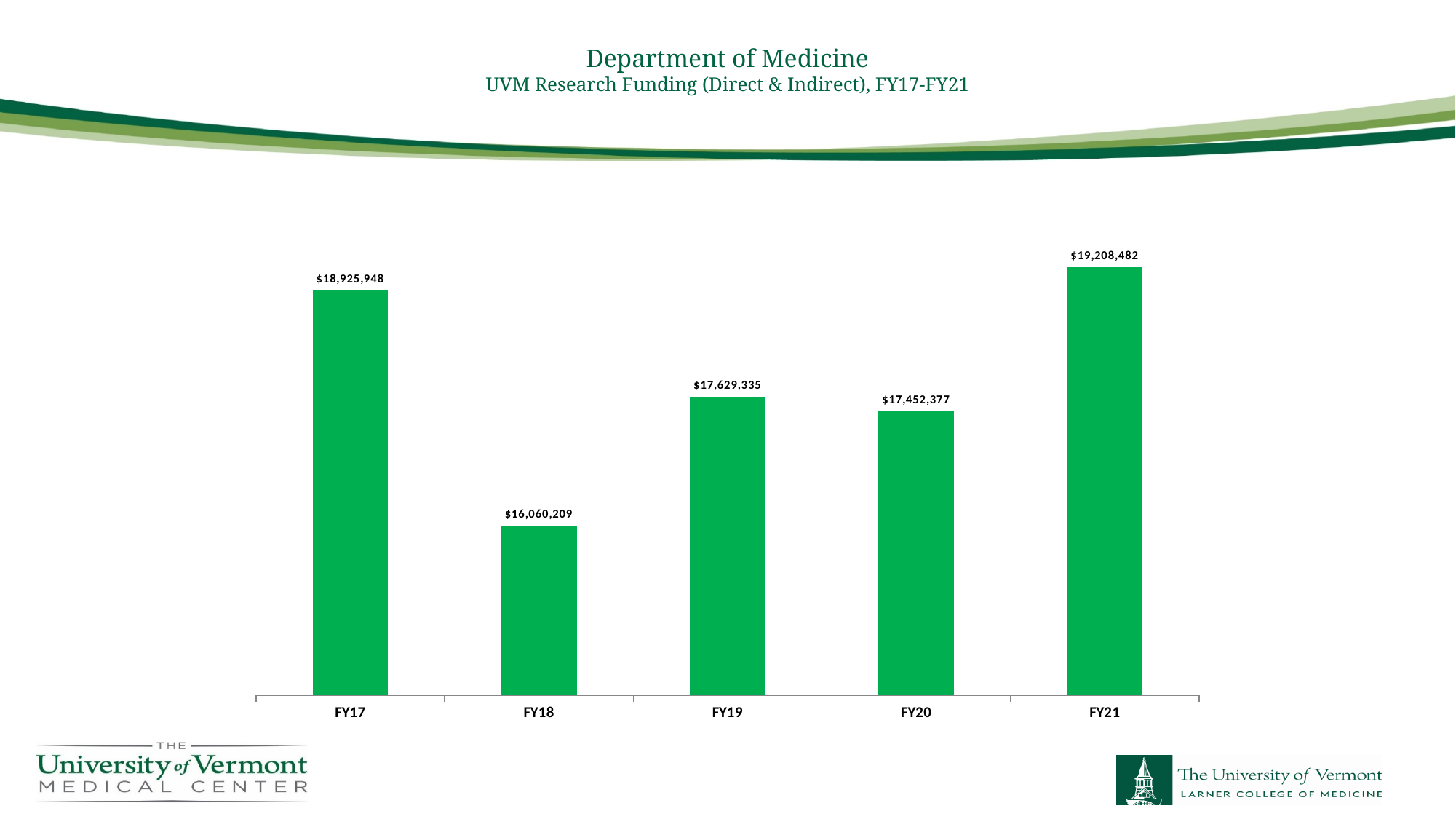
What is the value for FY17? $18,925,948 Which fiscal year has the lowest research funding? FY18 Does the value rise or fall from FY18 to FY19? Rise How many fiscal years are shown in the chart? 5 What is the value for FY20? $17,452,377 What is the difference between the FY17 and FY18 values? $2,865,739 Which fiscal year has the highest research funding? FY21 What kind of chart is shown on the slide? Bar chart What is the subtitle of the chart below 'Department of Medicine'? UVM Research Funding (Direct & Indirect), FY17-FY21 Which is larger, the value for FY19 or the value for FY20? FY19 What is the value for FY18? $16,060,209 What is the difference between the FY21 and FY17 values? $282,534